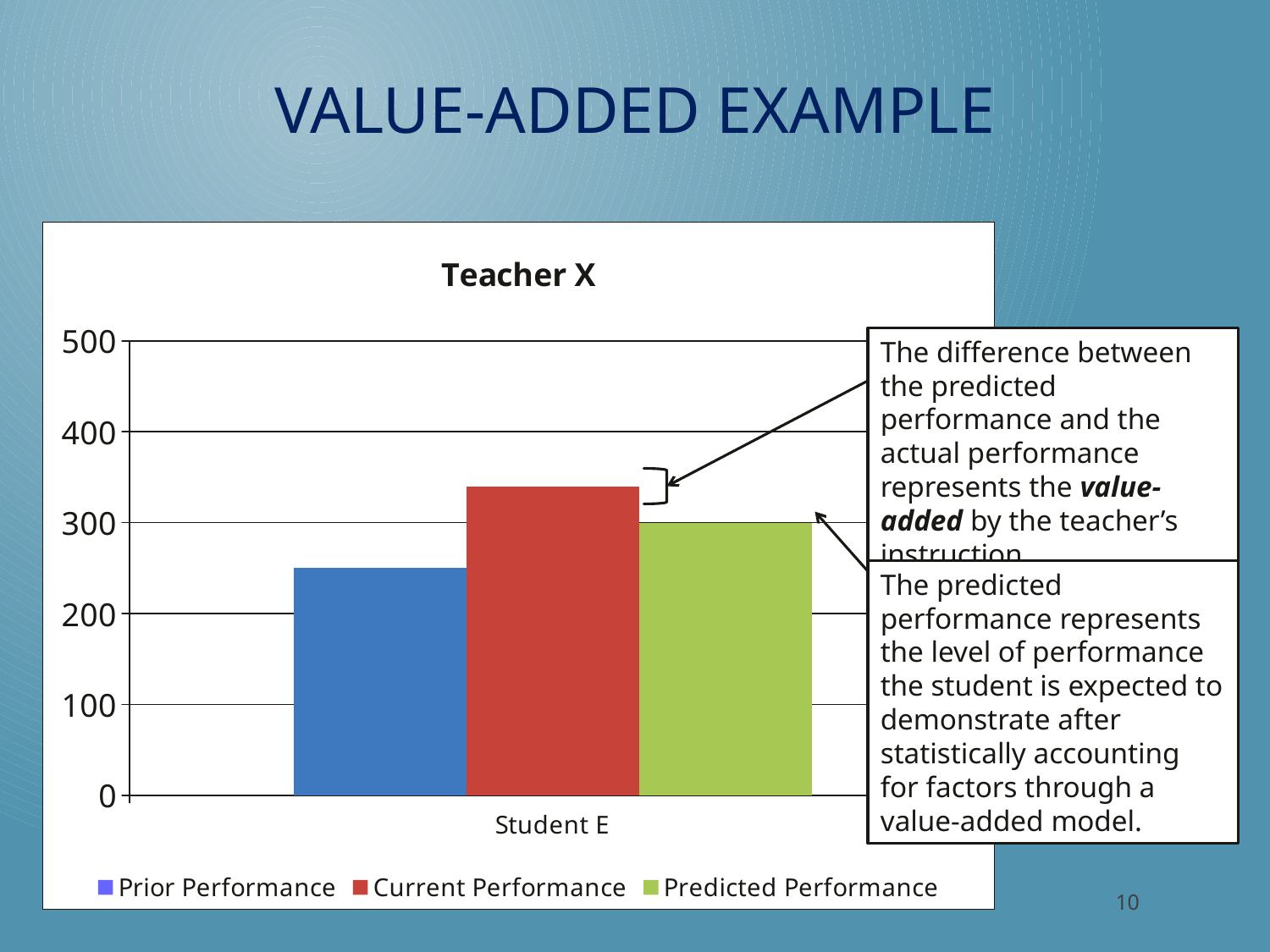
Is the value for Current Performance greater or less than 300? greater Is the value for Prior Performance greater or less than 200? greater Which is larger for Student E, Current Performance or Predicted Performance? Current Performance Which series has the highest value for Student E? Current Performance What is the label of the category on the x axis? Student E What type of chart is shown on the slide? bar chart Which series has the lowest value for Student E? Prior Performance What is the title of the chart? Teacher X How many series does the legend list? 3 How many categories are shown on the x axis? 1 Is the value for Current Performance greater or less than 400? less